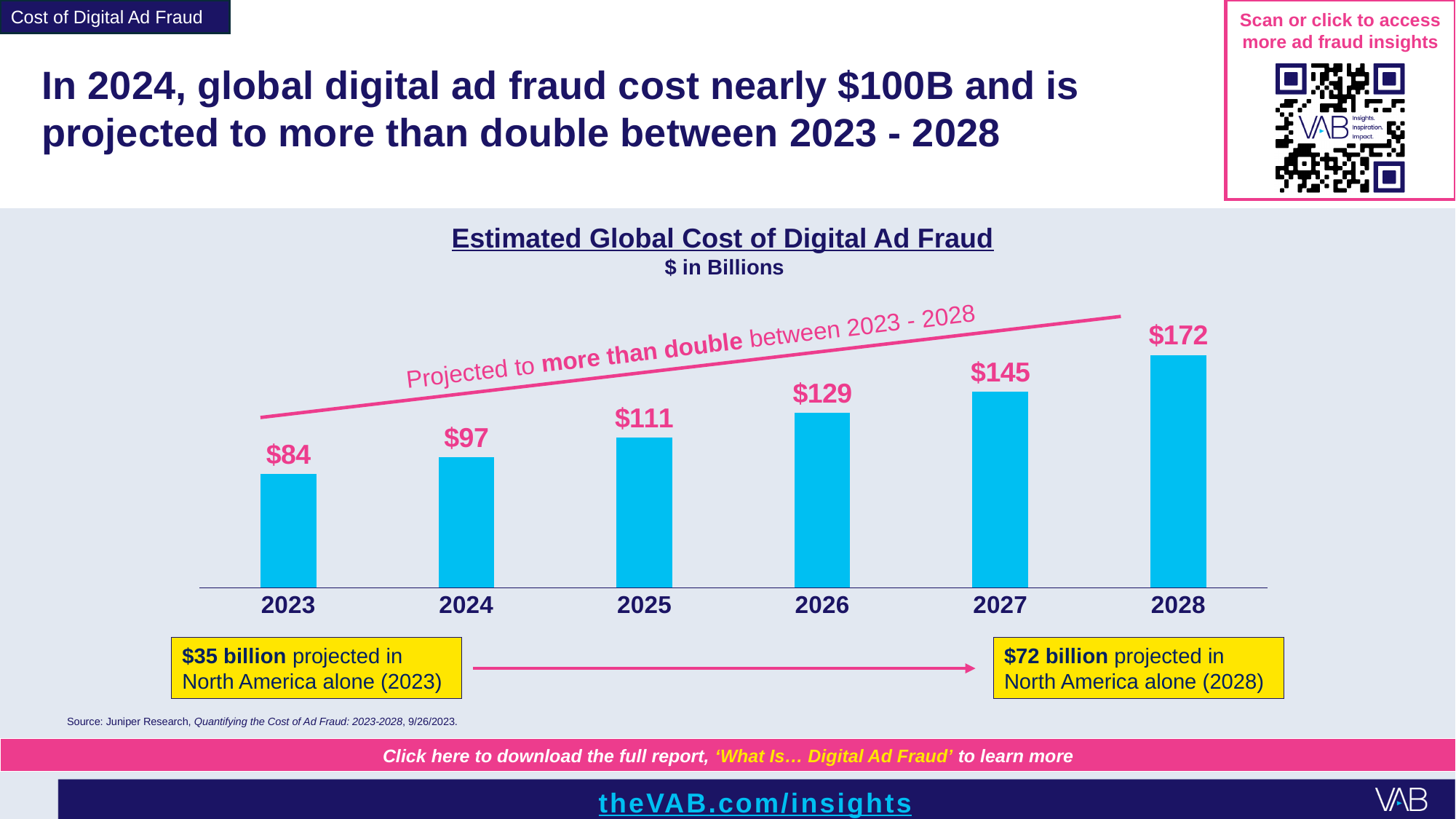
What is the estimated global cost of digital ad fraud for 2024? $97 What is the difference between the estimated cost in 2027 and in 2025? $34 What kind of chart is shown on the slide? Bar chart Do the estimated costs rise or fall from 2023 to 2028? Rise Which year has a larger estimated cost, 2025 or 2027? 2027 What is the difference between the estimated cost in 2028 and in 2023? $88 What is the estimated global cost of digital ad fraud for 2026? $129 Which year has the highest estimated global cost of digital ad fraud? 2028 What is the title of the chart? Estimated Global Cost of Digital Ad Fraud Which year has the lowest estimated global cost of digital ad fraud? 2023 What is the estimated global cost of digital ad fraud for 2028? $172 How many years are shown on the chart? 6